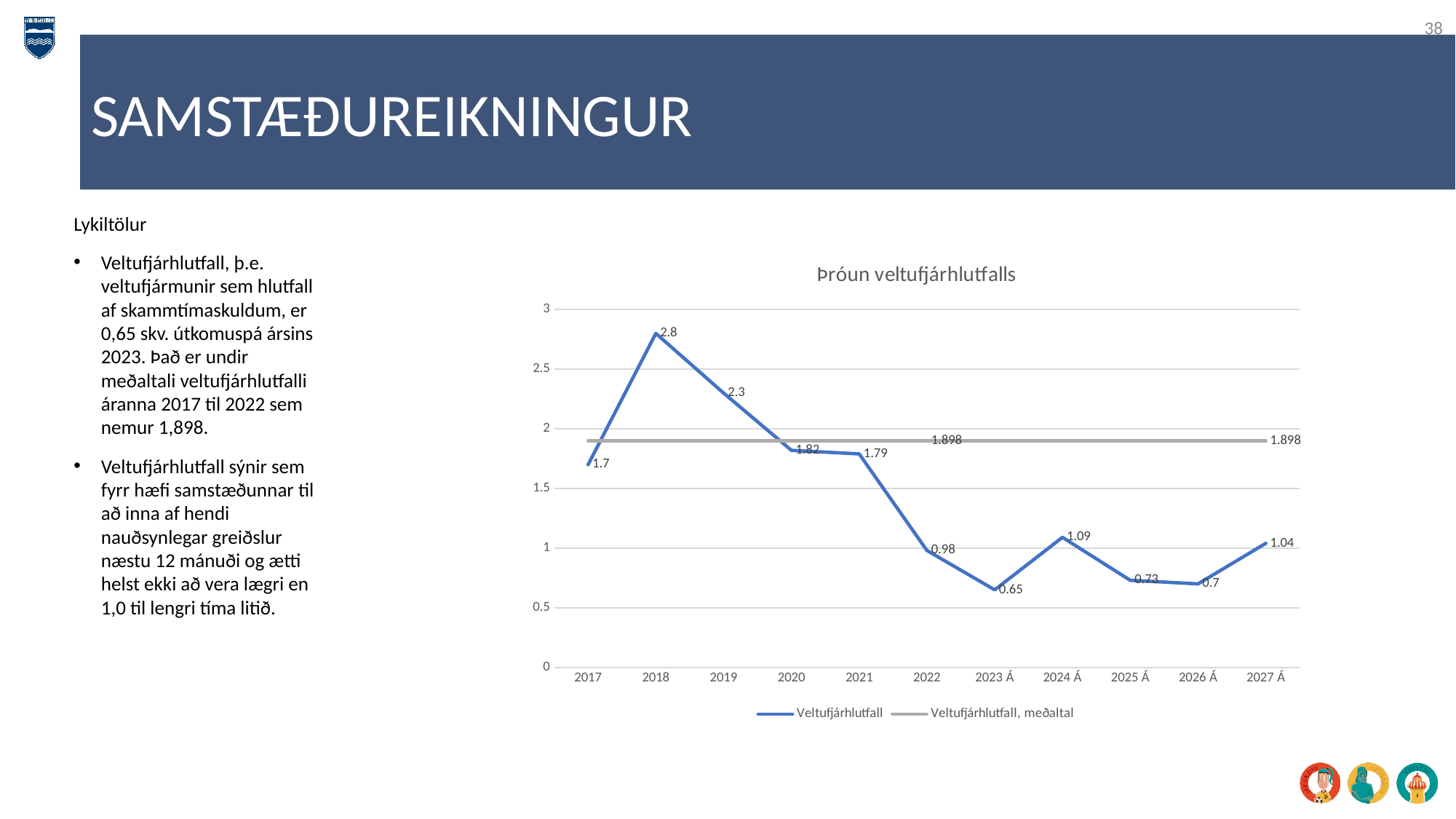
What is the value of Veltufjárhlutfall for 2018? 2.8 Which is larger, the Veltufjárhlutfall value for 2024 Á or for 2025 Á? 2024 Á In which year is Veltufjárhlutfall lowest? 2023 Á What type of chart is shown on the slide? line chart What is the value of Veltufjárhlutfall for 2023 Á? 0.65 How many series does the chart legend list? 2 How many years are shown on the x axis of the chart? 11 What is the difference between the Veltufjárhlutfall values for 2018 and 2019? 0.5 What is the title of the chart? Þróun veltufjárhlutfalls What is the value of the Veltufjárhlutfall, meðaltal line? 1.898 In which year is Veltufjárhlutfall highest? 2018 What is the value of Veltufjárhlutfall for 2027 Á? 1.04